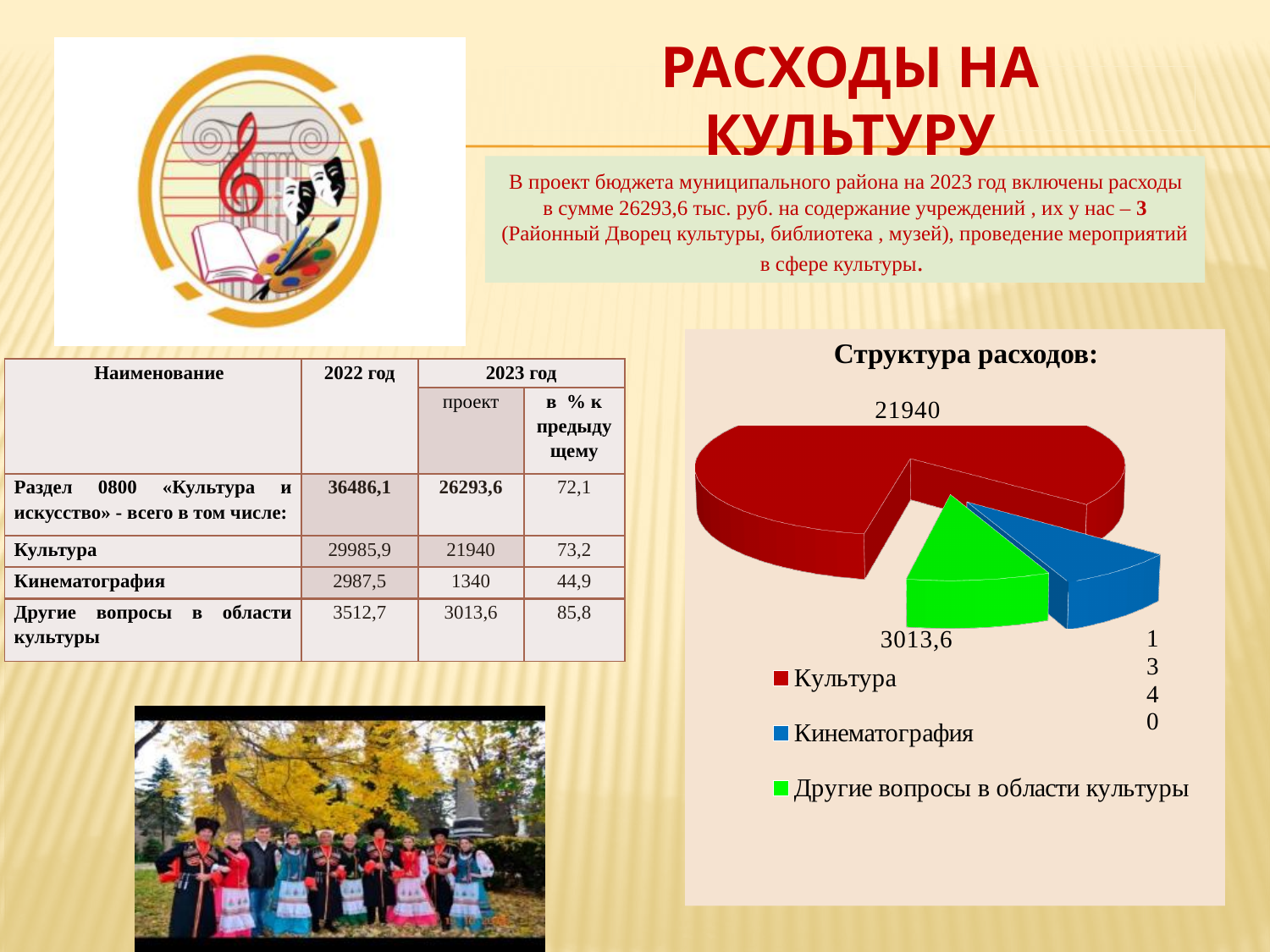
What is the value shown for Кинематография in the pie chart? 1340 Which category has the largest slice in the pie chart? Культура What colour is the Культура slice in the pie chart? red Which category has the smallest slice in the pie chart? Кинематография What is the value shown for Культура in the pie chart? 21940 What is the total of all three values shown in the pie chart? 26293,6 How many entries does the legend of the pie chart list? 3 How many slices does the pie chart have? 3 What is the difference between the values for Культура and Другие вопросы в области культуры in the pie chart? 18926,4 What kind of chart is shown under the heading "Структура расходов:"? pie chart Which is larger in the pie chart: Кинематография or Другие вопросы в области культуры? Другие вопросы в области культуры What is the value shown for Другие вопросы в области культуры in the pie chart? 3013,6